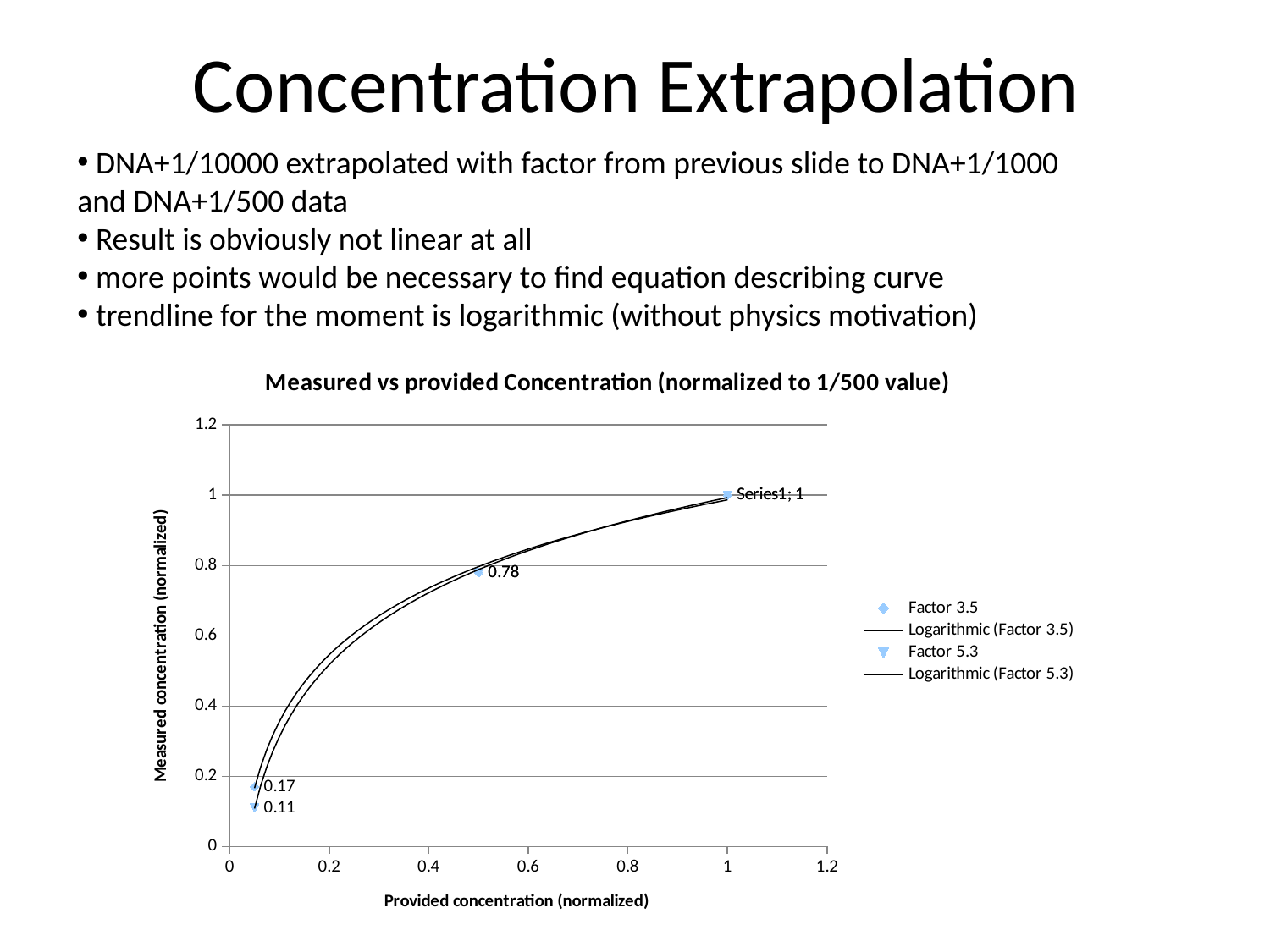
What is the difference between the two labeled values at the smallest provided concentration, 0.17 and 0.11? 0.06 How many data labels are printed on the chart? 4 How many entries does the chart legend list? 4 What kind of chart is shown on the slide? scatter chart What is the title of the chart? Measured vs provided Concentration (normalized to 1/500 value) Does the measured concentration rise or fall as the provided concentration increases? rise What is the highest measured concentration value labeled on the chart? 1 What is the title of the x axis? Provided concentration (normalized) What is the measured concentration labeled at a provided concentration of 0.5? 0.78 Is the labeled value 0.17 greater or less than 0.2 on the y axis? less What is the lowest measured concentration value labeled on the chart? 0.11 Which is larger, the labeled value 0.78 or the labeled value 0.17? 0.78